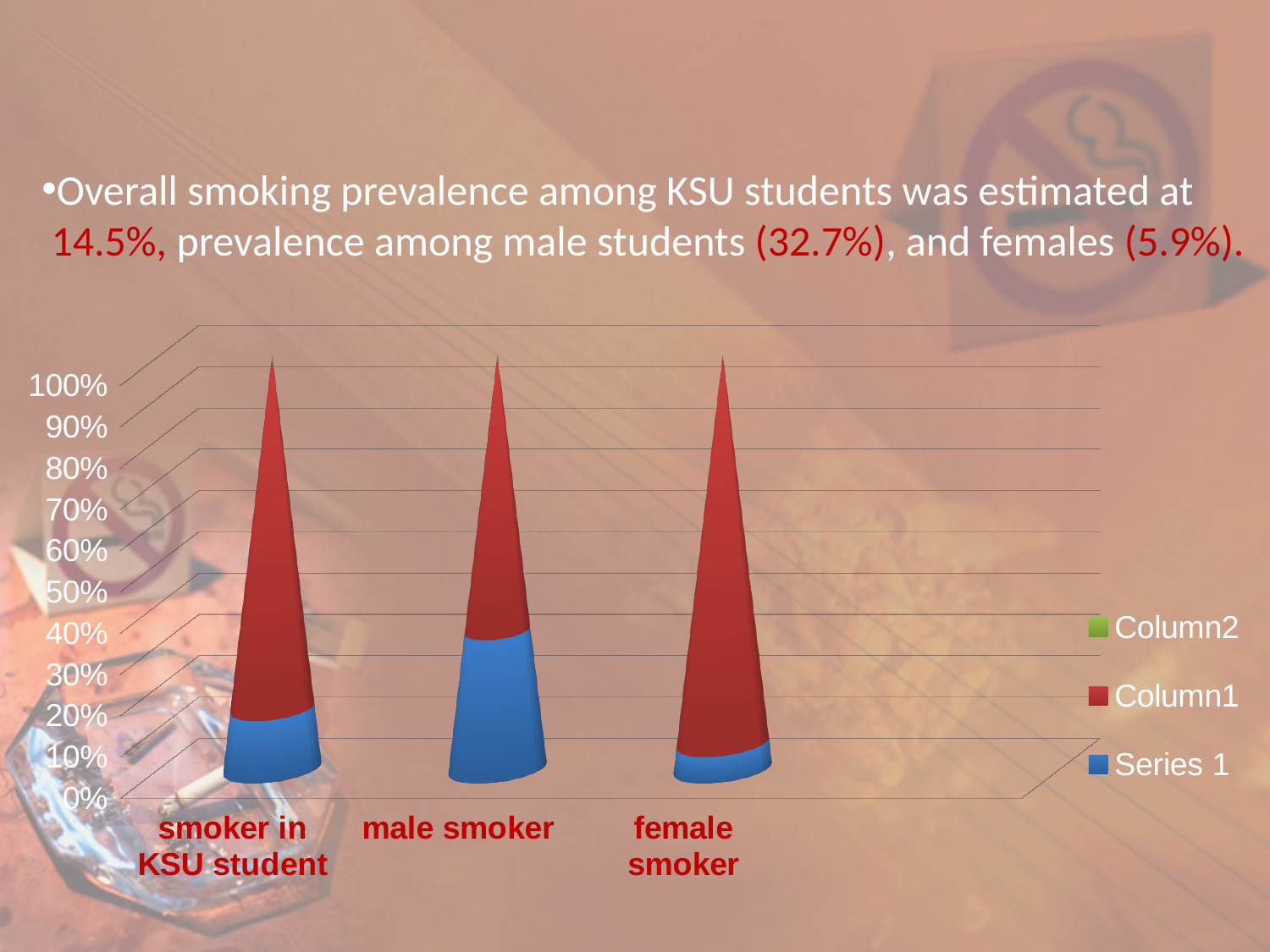
How many categories are shown on the x axis of the chart? 3 What is the label of the first category on the x axis? smoker in KSU student How many series does the chart's legend list? 3 What colour represents Column1 in the chart's legend? red Is the Series 1 (blue) portion larger for smoker in KSU student or for male smoker? male smoker What kind of chart is shown on the slide? bar chart Is the Series 1 value for smoker in KSU student greater or less than 20%? less Is the Series 1 value for male smoker greater or less than 20%? greater Which category has the largest Series 1 (blue) portion? male smoker Is the Series 1 (blue) portion larger for male smoker or for female smoker? male smoker Which category has the smallest Series 1 (blue) portion? female smoker Is the Series 1 value for female smoker greater or less than 10%? less